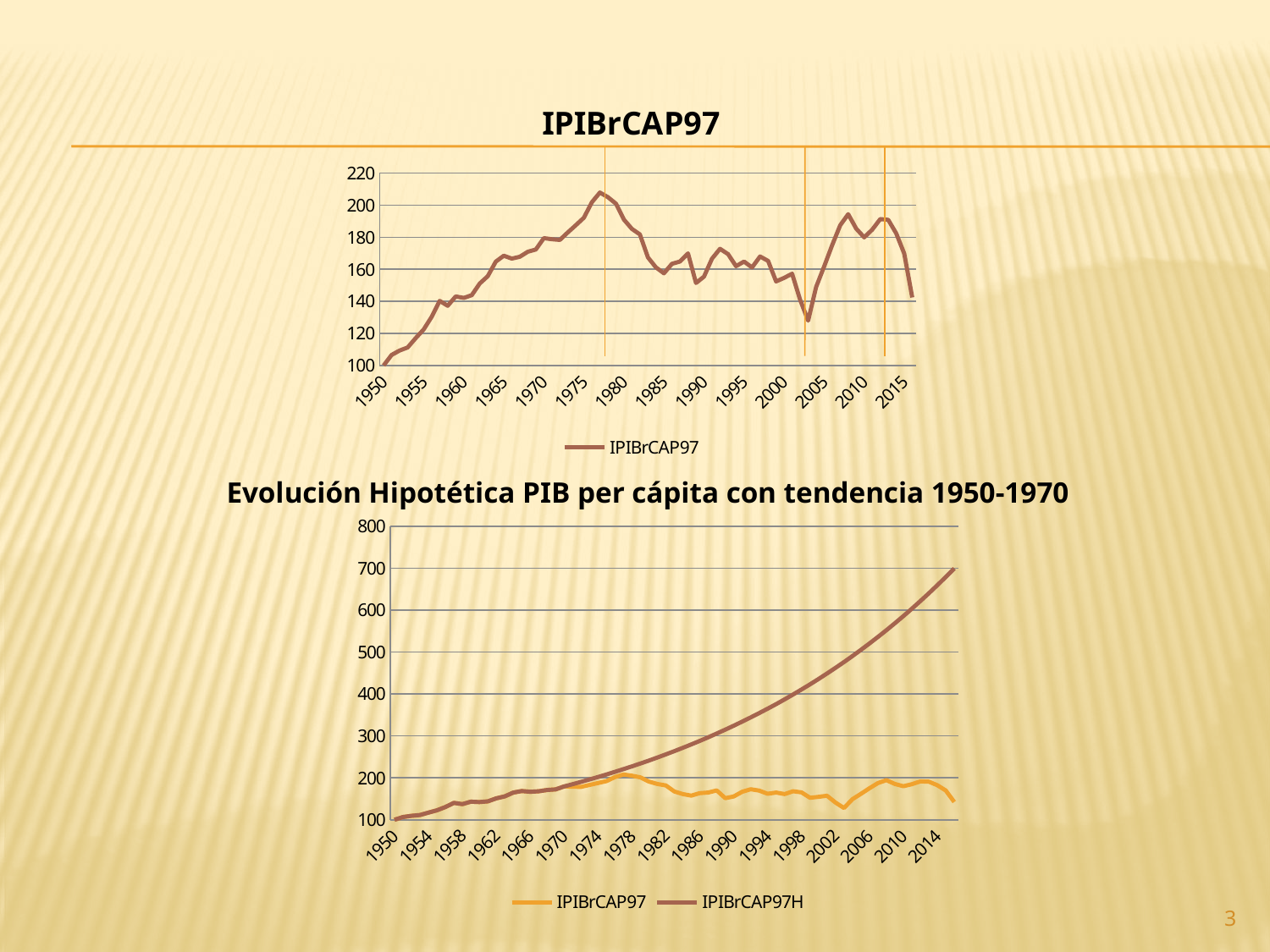
How many series does the legend of the bottom chart list? 2 In the bottom chart, is the value of IPIBrCAP97H for 2014 greater or less than 600? greater In the top chart IPIBrCAP97, is the value for 1975 greater or less than 180? greater In the top chart IPIBrCAP97, is the value for 1970 greater or less than 160? greater In the bottom chart, does the IPIBrCAP97H series rise or fall from 1950 to 2014? rise In the bottom chart, what colour is the IPIBrCAP97 line? orange What kind of chart is the top chart titled IPIBrCAP97? line chart How many series does the legend of the top chart IPIBrCAP97 list? 1 What kind of chart is the bottom chart titled 'Evolución Hipotética PIB per cápita con tendencia 1950-1970'? line chart In the bottom chart, which series has the higher value in 2010, IPIBrCAP97 or IPIBrCAP97H? IPIBrCAP97H